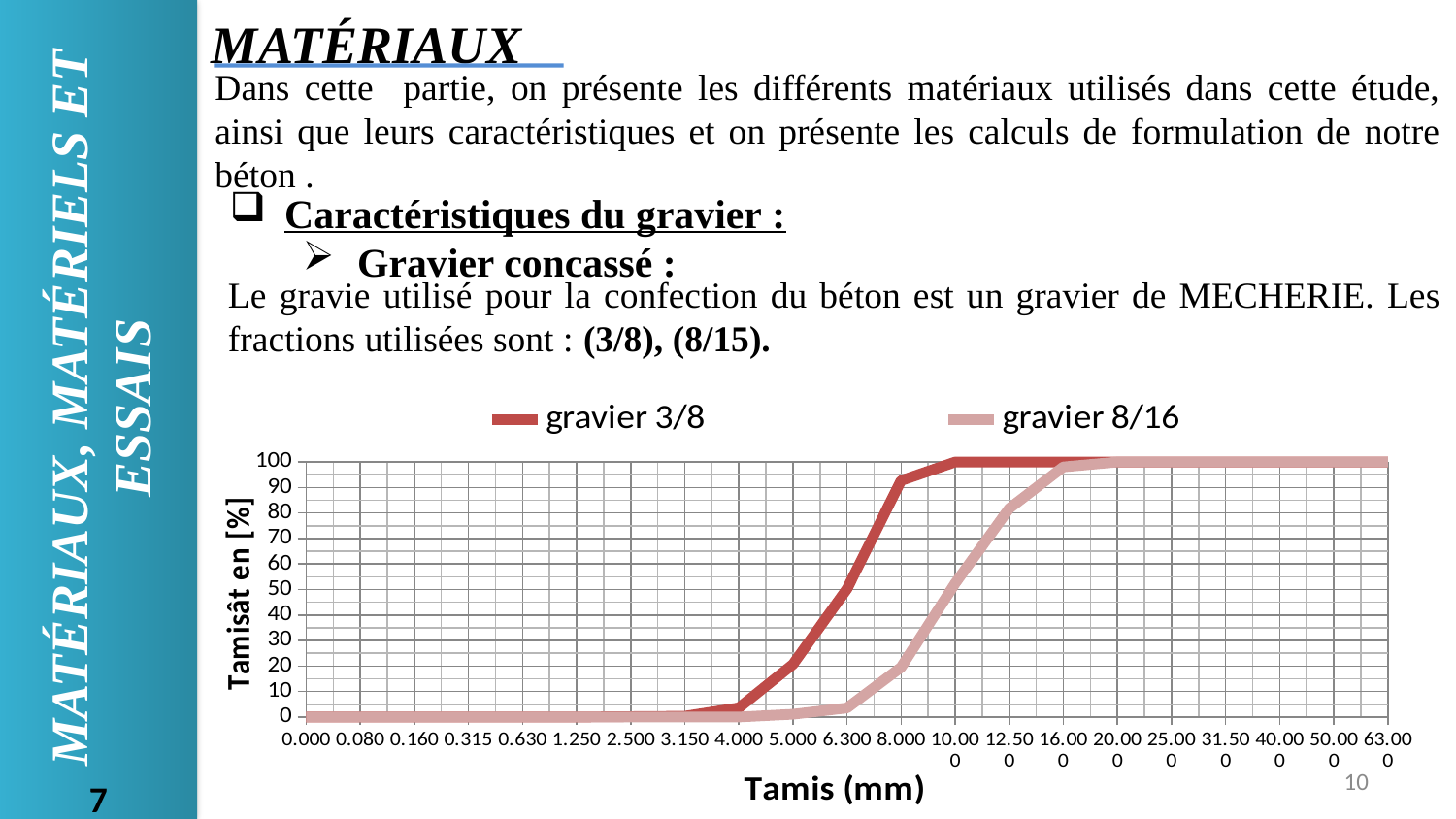
Is the value for gravier 8/16 at 8.000 mm greater or less than 30? less What is the title of the x axis of the chart? Tamis (mm) What is the value for gravier 8/16 at 0.000 mm? 0 Is the value for gravier 3/8 at 8.000 mm greater or less than 80? greater Is the value for gravier 8/16 at 12.500 mm greater or less than 70? greater How many series does the chart legend list? 2 What is the title of the y axis of the chart? Tamisât en [%] How many sieve sizes (categories) are shown along the x axis of the chart? 21 At 8.000 mm, which series has the higher value, gravier 3/8 or gravier 8/16? gravier 3/8 What kind of chart is shown on the slide? line chart Do the values for gravier 3/8 rise or fall as the sieve size increases along the x axis? rise